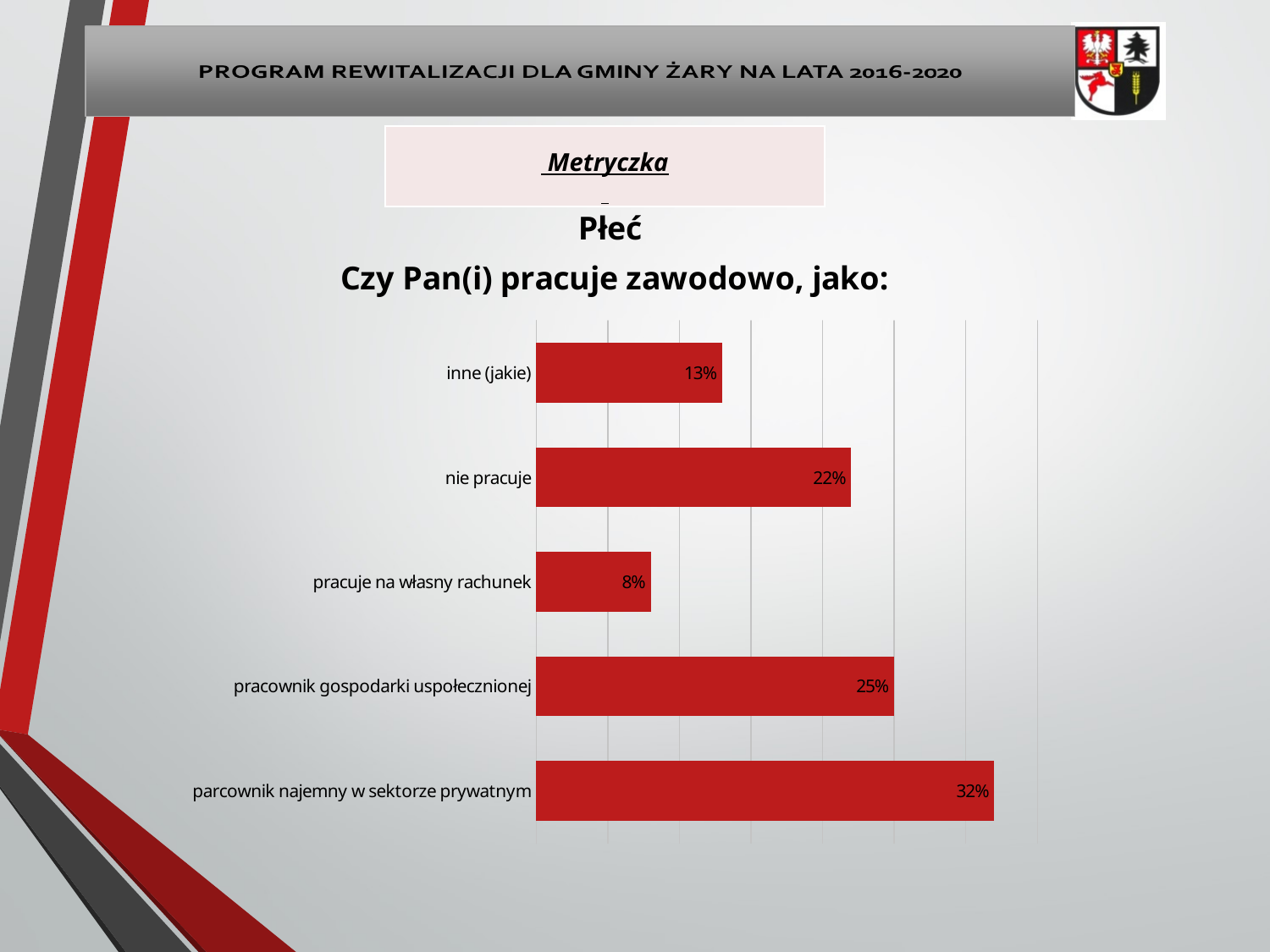
How many categories are shown in the chart? 5 What kind of chart is shown on the slide? bar chart Which is larger: the value for "nie pracuje" or the value for "inne (jakie)"? nie pracuje What is the difference between the values for "parcownik najemny w sektorze prywatnym" and "pracownik gospodarki uspołecznionej"? 7% What is the value for "inne (jakie)"? 13% Which category has the lowest value? pracuje na własny rachunek What is the value for "nie pracuje"? 22% What is the value for "parcownik najemny w sektorze prywatnym"? 32% What is the difference between the values for "nie pracuje" and "pracuje na własny rachunek"? 14% What question does the chart title ask? Czy Pan(i) pracuje zawodowo, jako: Which category has the highest value? parcownik najemny w sektorze prywatnym What is the value for "pracuje na własny rachunek"? 8%